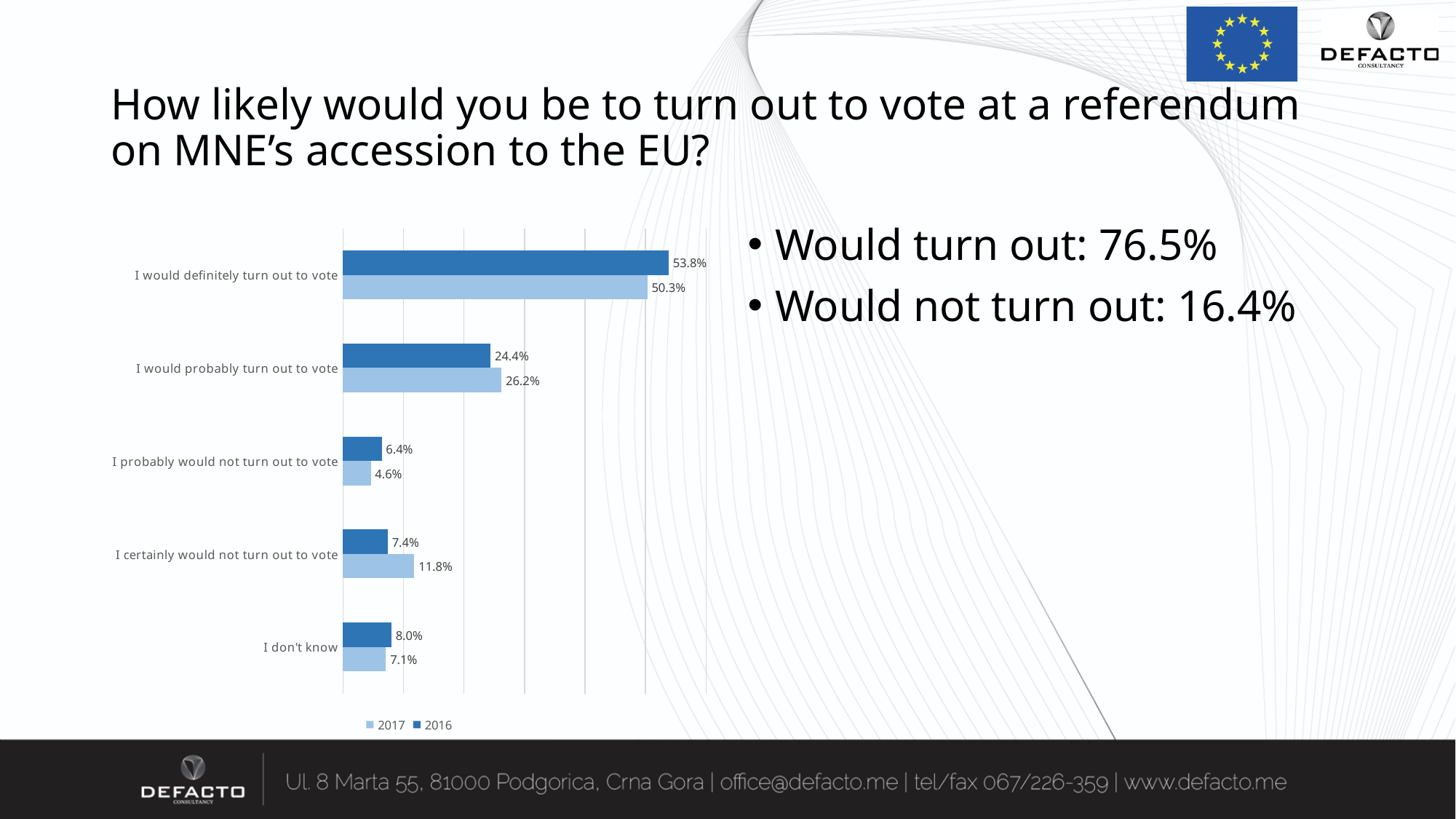
What is the 2016 value for 'I don't know'? 8.0% How many series does the legend list? 2 How many response categories are shown in the chart? 5 Which response category has the lowest value for 2017? I probably would not turn out to vote What type of chart is shown on the slide? Bar chart Which years are listed in the chart legend? 2017 and 2016 What percentage of respondents in 2017 said they would probably turn out to vote? 26.2% Which response category has the highest value for 2017? I would definitely turn out to vote Which is larger for 'I certainly would not turn out to vote': the 2016 value or the 2017 value? 2017 What percentage of respondents in 2016 said they would definitely turn out to vote? 53.8% What is the difference between the 2016 and 2017 values for 'I would definitely turn out to vote'? 3.5% What is the 2017 value for 'I certainly would not turn out to vote'? 11.8%